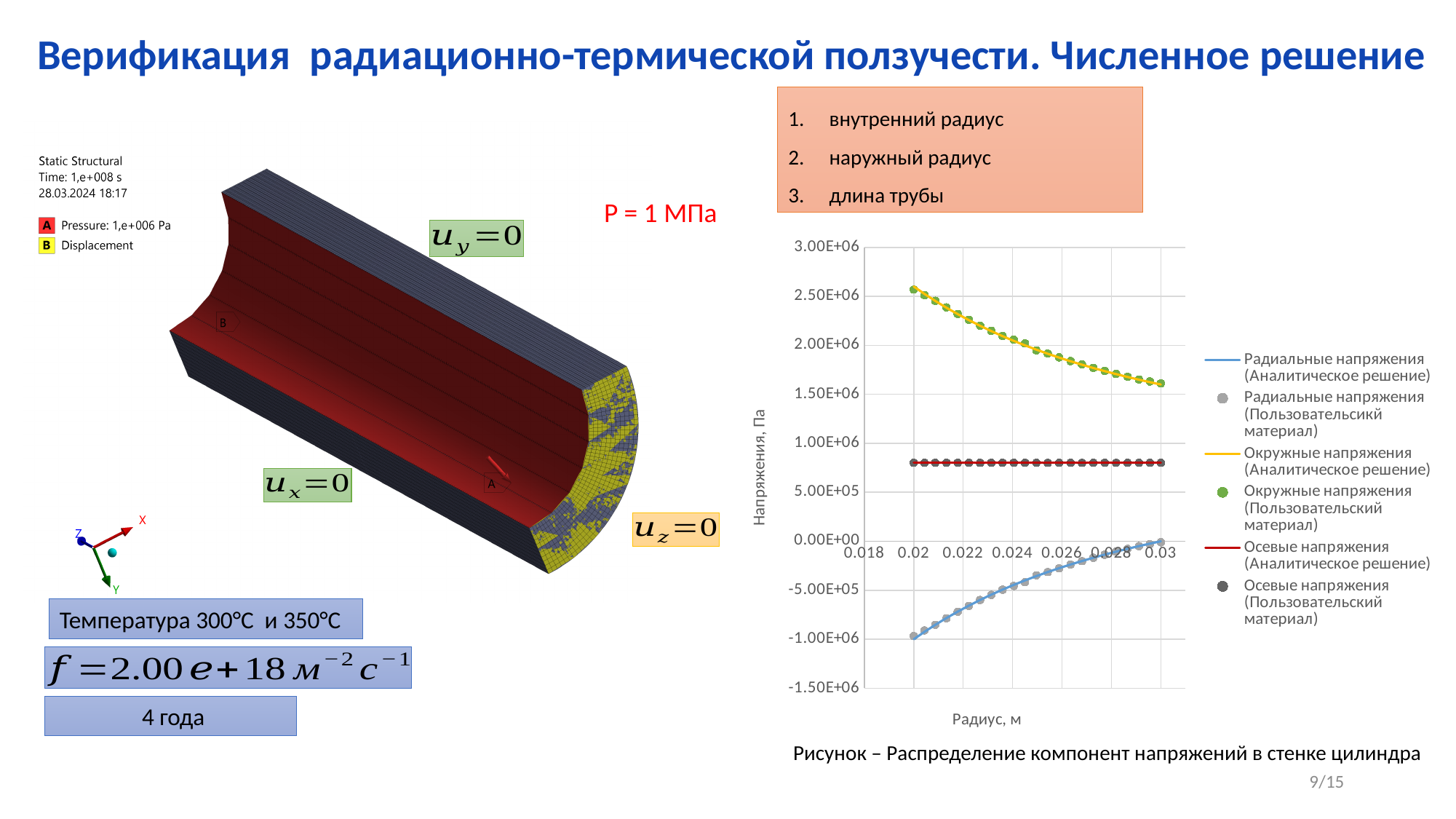
Which series has the lowest values on the chart? Радиальные напряжения Do the values of the Радиальные напряжения series rise or fall as the radius increases? rise How many series does the chart legend list? 6 What kind of chart is shown on the slide? line chart At a radius of 0.03, which is larger: Окружные напряжения or Осевые напряжения? Окружные напряжения Is the value of Радиальные напряжения at a radius of 0.026 greater or less than -5.00E+05? greater Is the value of Осевые напряжения greater or less than 1.00E+06? less Which series has the highest values on the chart? Окружные напряжения What is the title of the vertical axis of the chart? Напряжения, Па Do the values of the Окружные напряжения series rise or fall as the radius increases? fall What is the title of the horizontal axis of the chart? Радиус, м Is the value of Окружные напряжения at a radius of 0.03 greater or less than 1.50E+06? greater